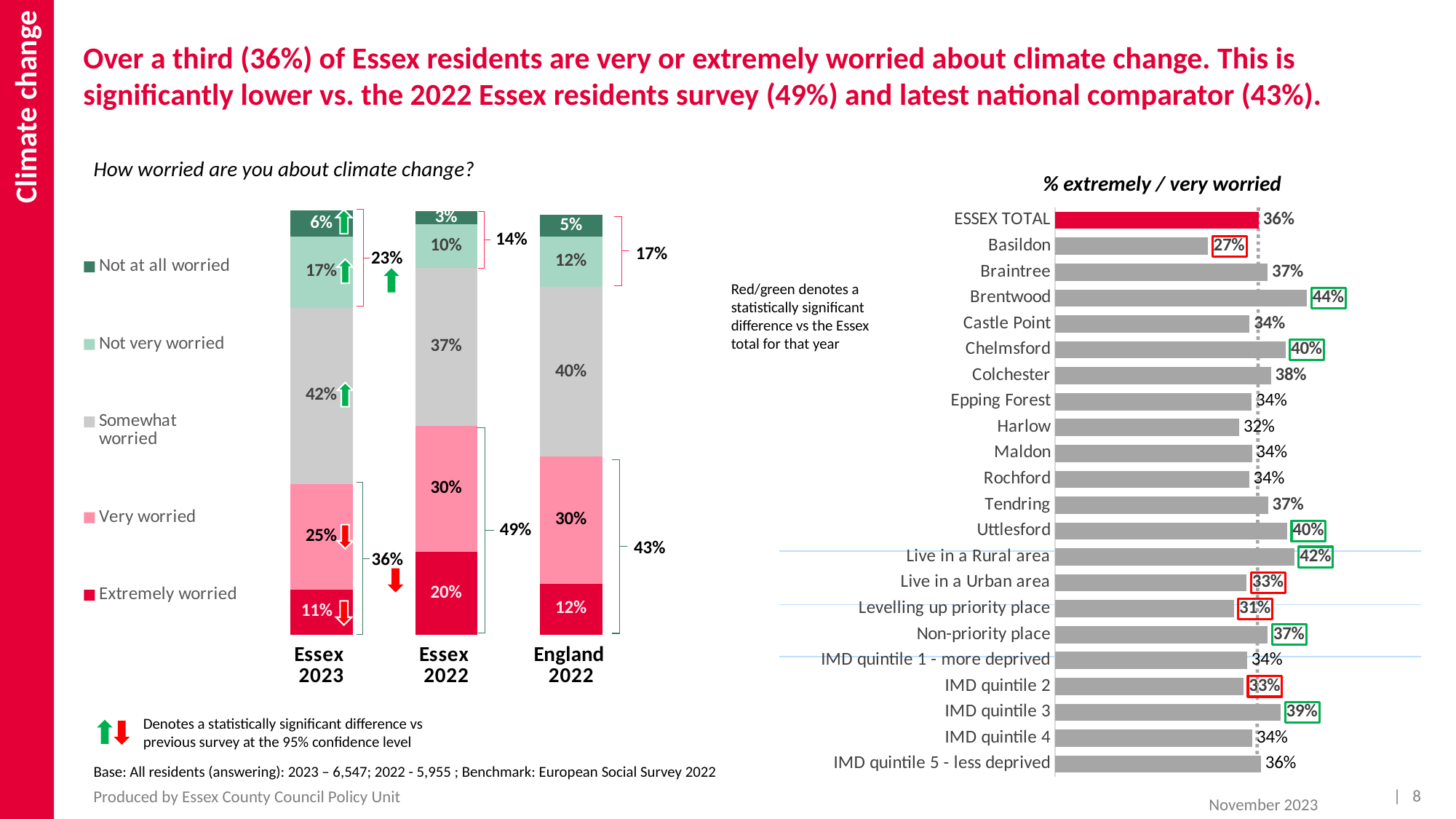
In the '% extremely / very worried' chart, which category has the lowest value? Basildon In the 'How worried are you about climate change?' chart, what is the combined share of 'Very worried' and 'Extremely worried' for England 2022? 43% In the 'How worried are you about climate change?' chart, what percentage of Essex 2023 respondents are 'Extremely worried'? 11% In the 'How worried are you about climate change?' chart, how many series does the legend list? 5 In the '% extremely / very worried' chart, what is the difference between the values for 'Live in a Rural area' and 'Live in a Urban area'? 9% In the '% extremely / very worried' chart, what is the value for Brentwood? 44% What kind of chart is the 'How worried are you about climate change?' chart? Stacked bar chart In the '% extremely / very worried' chart, what is the value for ESSEX TOTAL? 36% In the '% extremely / very worried' chart, which is larger, the value for Chelmsford or the value for Colchester? Chelmsford In the '% extremely / very worried' chart, which category has the highest value? Brentwood In the 'How worried are you about climate change?' chart, what percentage of Essex 2022 respondents are 'Somewhat worried'? 37% In the '% extremely / very worried' chart, how many bars are plotted? 22